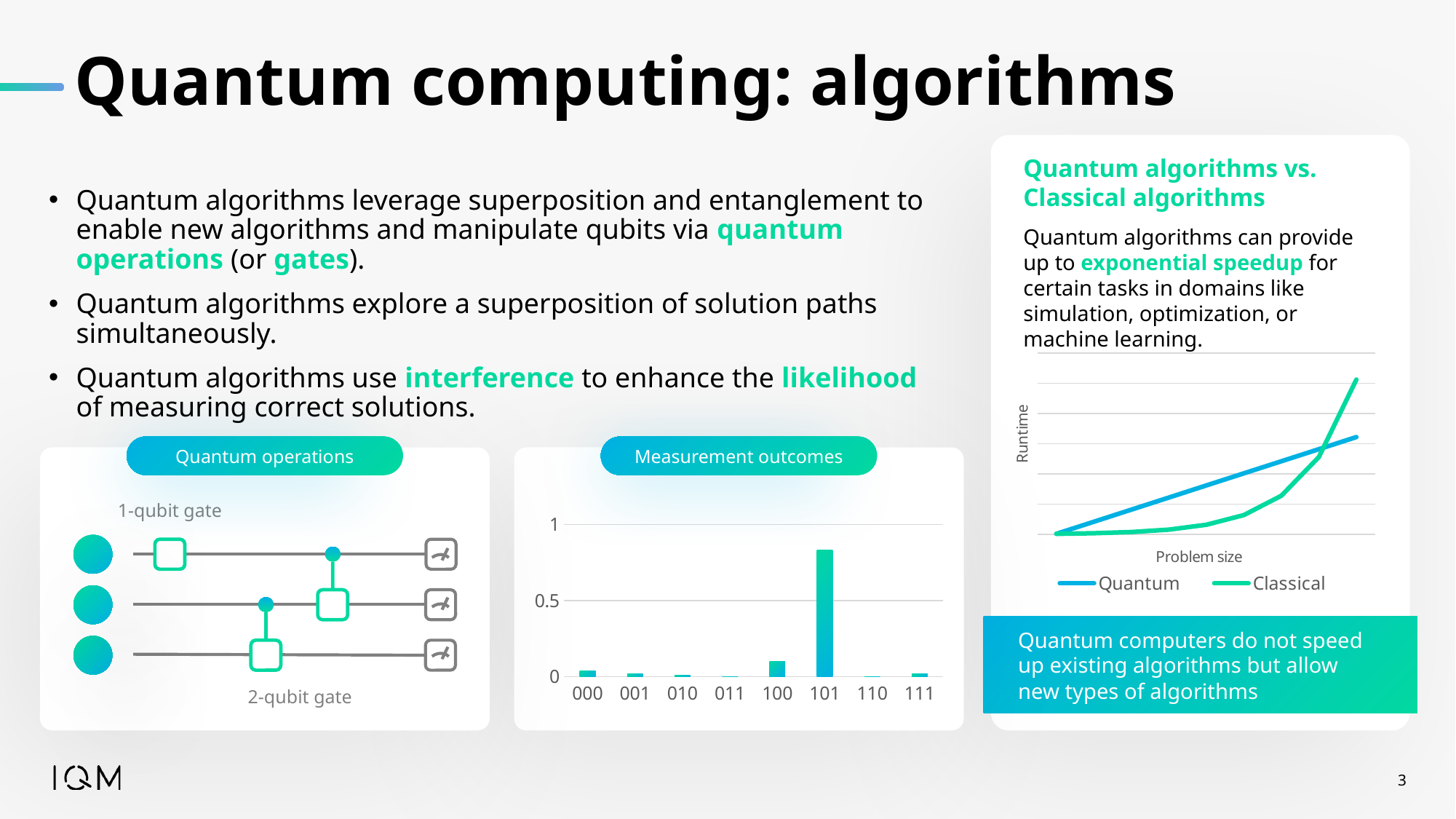
In the Measurement outcomes chart, which outcome has the highest bar? 101 In the Quantum algorithms vs. Classical algorithms chart, which series has the higher runtime at the largest problem size, Quantum or Classical? Classical In the Measurement outcomes chart, is the value for 101 greater or less than 0.5? greater What kind of chart is the Measurement outcomes chart? bar chart How many series does the legend of the Quantum algorithms vs. Classical algorithms chart list? 2 In the Quantum algorithms vs. Classical algorithms chart, does the Classical runtime rise or fall as problem size increases? rise In the Measurement outcomes chart, which is larger, the value for 101 or the value for 100? 101 What kind of chart is the Quantum algorithms vs. Classical algorithms chart? line chart In the Measurement outcomes chart, is the value for 100 greater or less than 0.5? less In the Measurement outcomes chart, which is larger, the value for 100 or the value for 011? 100 What is the label of the x axis in the Quantum algorithms vs. Classical algorithms chart? Problem size How many categories are shown on the x axis of the Measurement outcomes chart? 8